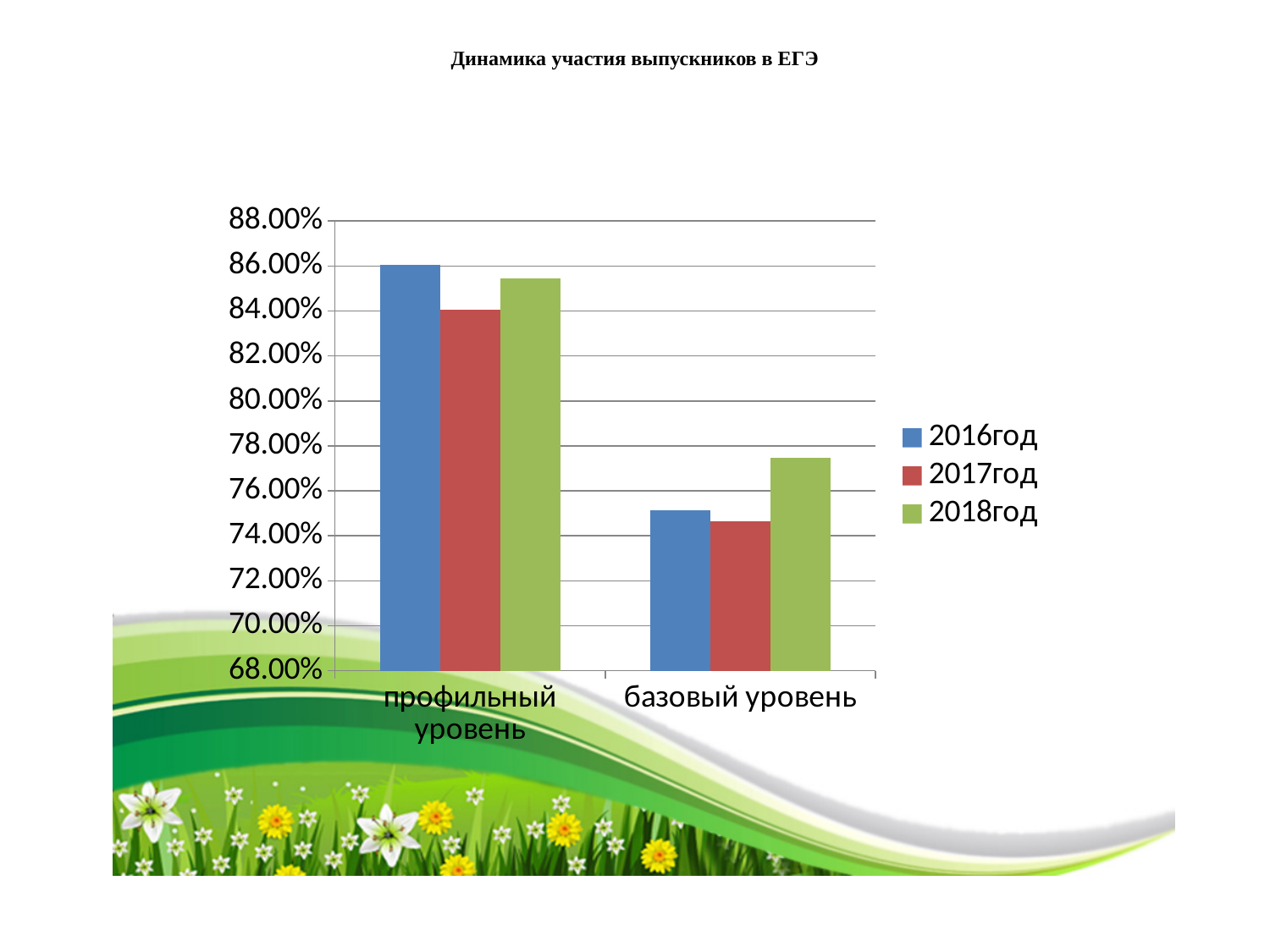
Is the value for 2016год in профильный уровень greater or less than 84.00%? greater What kind of chart is shown on the slide? bar chart How many series does the legend list? 3 How many categories are shown on the x axis? 2 For 2016год, which category has the larger value: профильный уровень or базовый уровень? профильный уровень What is the title of the slide? Динамика участия выпускников в ЕГЭ For профильный уровень, which year has the lowest value? 2017год Is the value for 2018год in базовый уровень greater or less than 76.00%? greater For 2018год, which category has the larger value: профильный уровень or базовый уровень? профильный уровень Is the value for 2017год in базовый уровень greater or less than 76.00%? less For базовый уровень, which year has the highest value? 2018год Which series is shown in green in the legend? 2018год